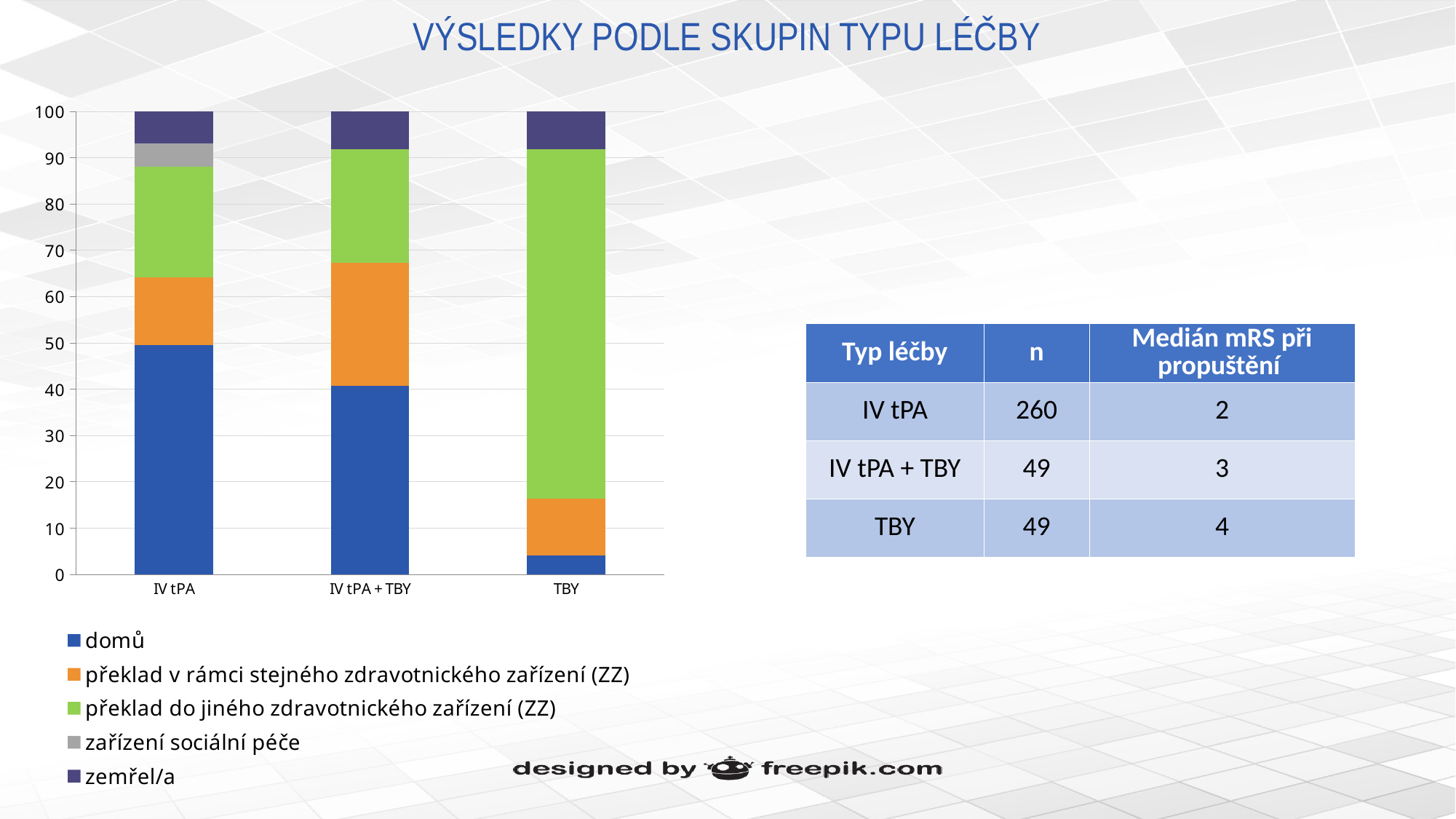
How many series does the chart legend list? 5 Which treatment group has the largest 'domů' (blue) segment? IV tPA Is the 'domů' value for TBY greater or less than 10? less What is the title of the slide containing the chart? VÝSLEDKY PODLE SKUPIN TYPU LÉČBY Which treatment group has the smallest 'domů' (blue) segment? TBY Is the 'domů' value for IV tPA + TBY greater or less than 30? greater How many treatment groups (categories) are shown on the x axis of the chart? 3 Which treatment group is the only one with a 'zařízení sociální péče' (gray) segment? IV tPA What is the total height of the stacked bar for IV tPA? 100 What kind of chart is shown on the slide? stacked bar chart Which treatment group has the largest 'překlad do jiného zdravotnického zařízení (ZZ)' (green) segment? TBY Is the 'domů' segment larger for IV tPA or for TBY? IV tPA